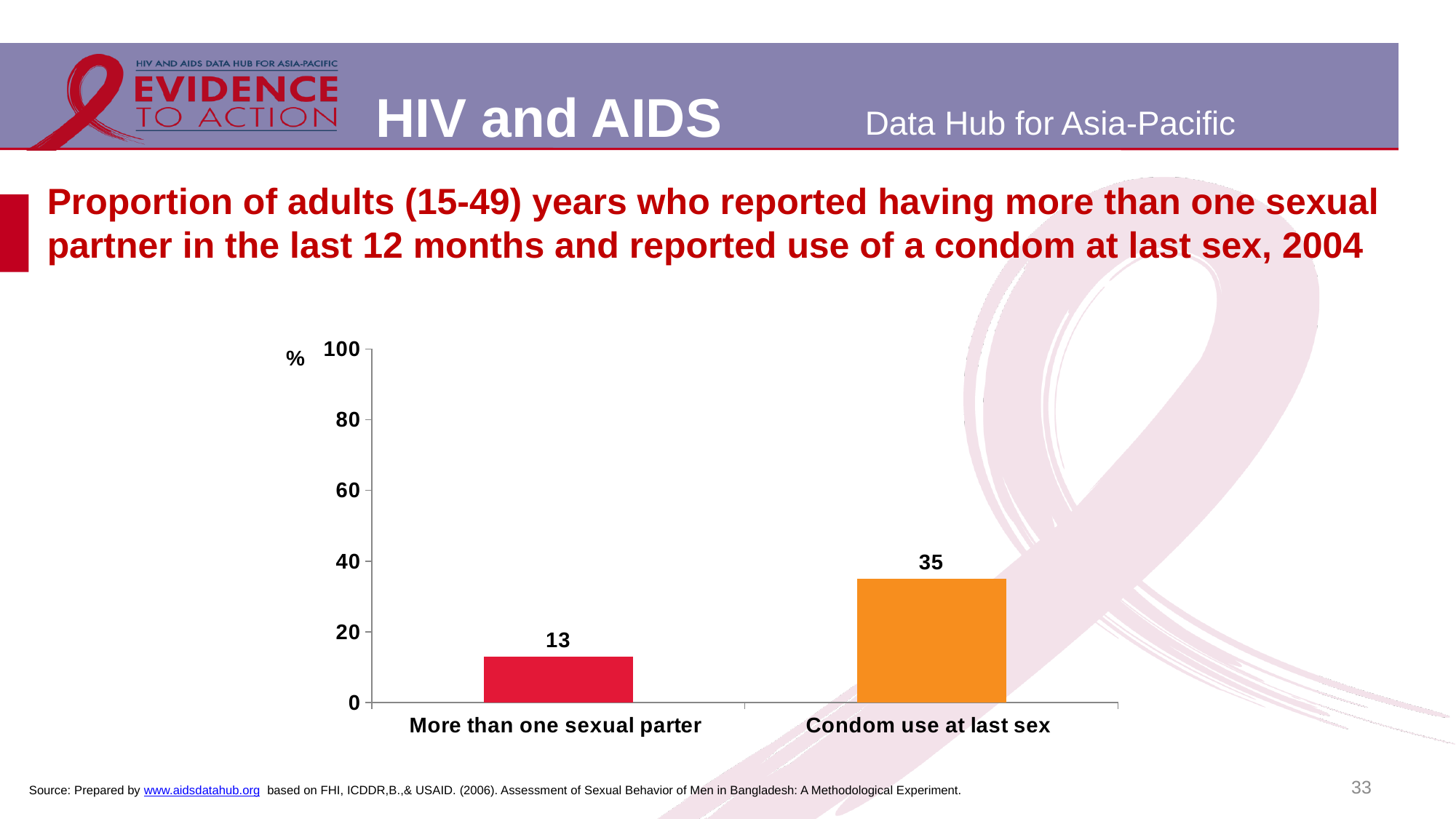
Which category has the highest value? Condom use at last sex Is the value for 'Condom use at last sex' greater or less than 40? less What is the value for 'More than one sexual parter'? 13 How many categories are shown on the chart? 2 Is the value for 'More than one sexual parter' greater or less than 20? less What is the value for 'Condom use at last sex'? 35 What kind of chart is shown on the slide? Bar chart Which category has the lowest value? More than one sexual parter What is the maximum value shown on the y axis of the chart? 100 What is the unit label shown on the y axis of the chart? % Which is larger: the value for 'Condom use at last sex' or the value for 'More than one sexual parter'? Condom use at last sex What is the difference between the values for 'Condom use at last sex' and 'More than one sexual parter'? 22